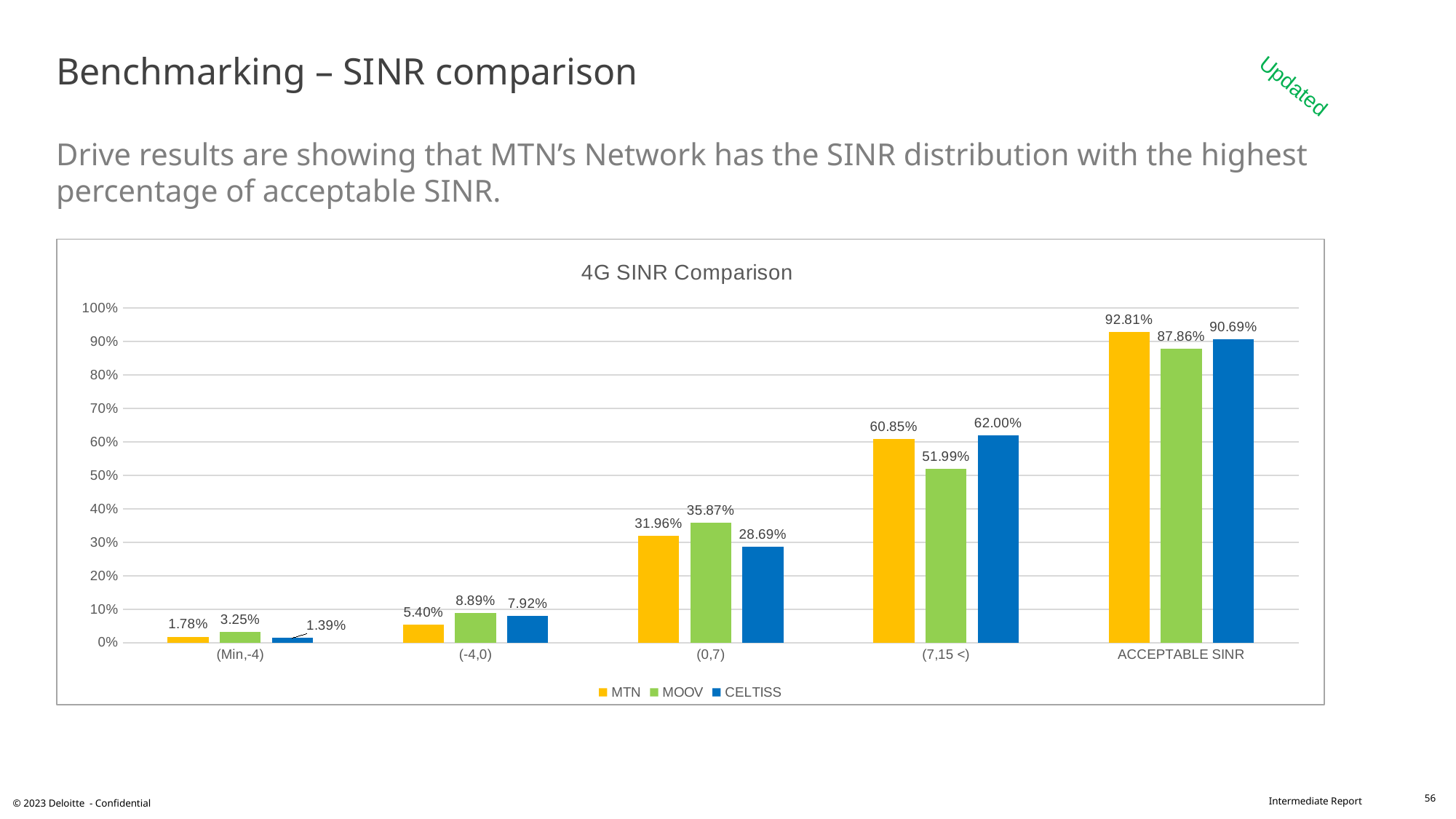
What kind of chart is shown? bar chart What is the value for MTN in the ACCEPTABLE SINR category? 92.81% What is the title of the chart? 4G SINR Comparison In the (7,15 <) category, which is larger: MTN or MOOV? MTN Which operator has the highest value in the ACCEPTABLE SINR category? MTN What is the value for CELTISS in the (7,15 <) category? 62.00% What is the value for MOOV in the (0,7) category? 35.87% How many series does the legend list? 3 Which operator has the lowest value in the (Min,-4) category? CELTISS Is the value for CELTISS in the (0,7) category greater or less than 30%? less How many categories are shown on the x axis? 5 What is the difference between MTN and MOOV in the ACCEPTABLE SINR category? 4.95%